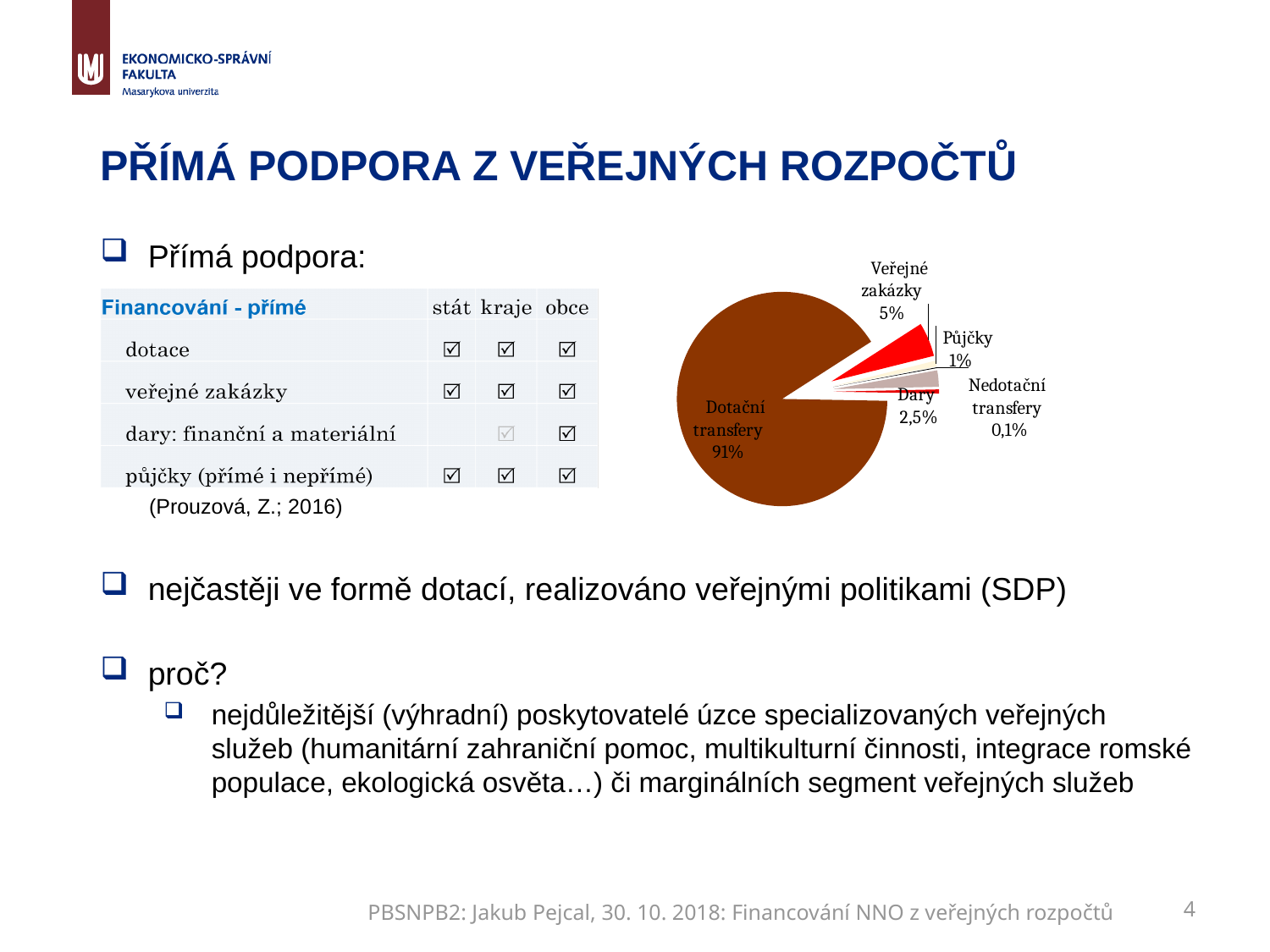
What share of the pie does "Veřejné zakázky" have? 5% Which slice of the pie chart is the smallest? Nedotační transfery What share of the pie does "Půjčky" have? 1% What share of the pie does "Dary" have? 2,5% What colour is the "Dotační transfery" slice of the pie chart? brown Which slice of the pie chart is the largest? Dotační transfery What is the difference in percentage points between "Veřejné zakázky" and "Půjčky"? 4 What kind of chart is shown on the slide? pie chart Which is larger in the pie chart, "Veřejné zakázky" or "Dary"? Veřejné zakázky